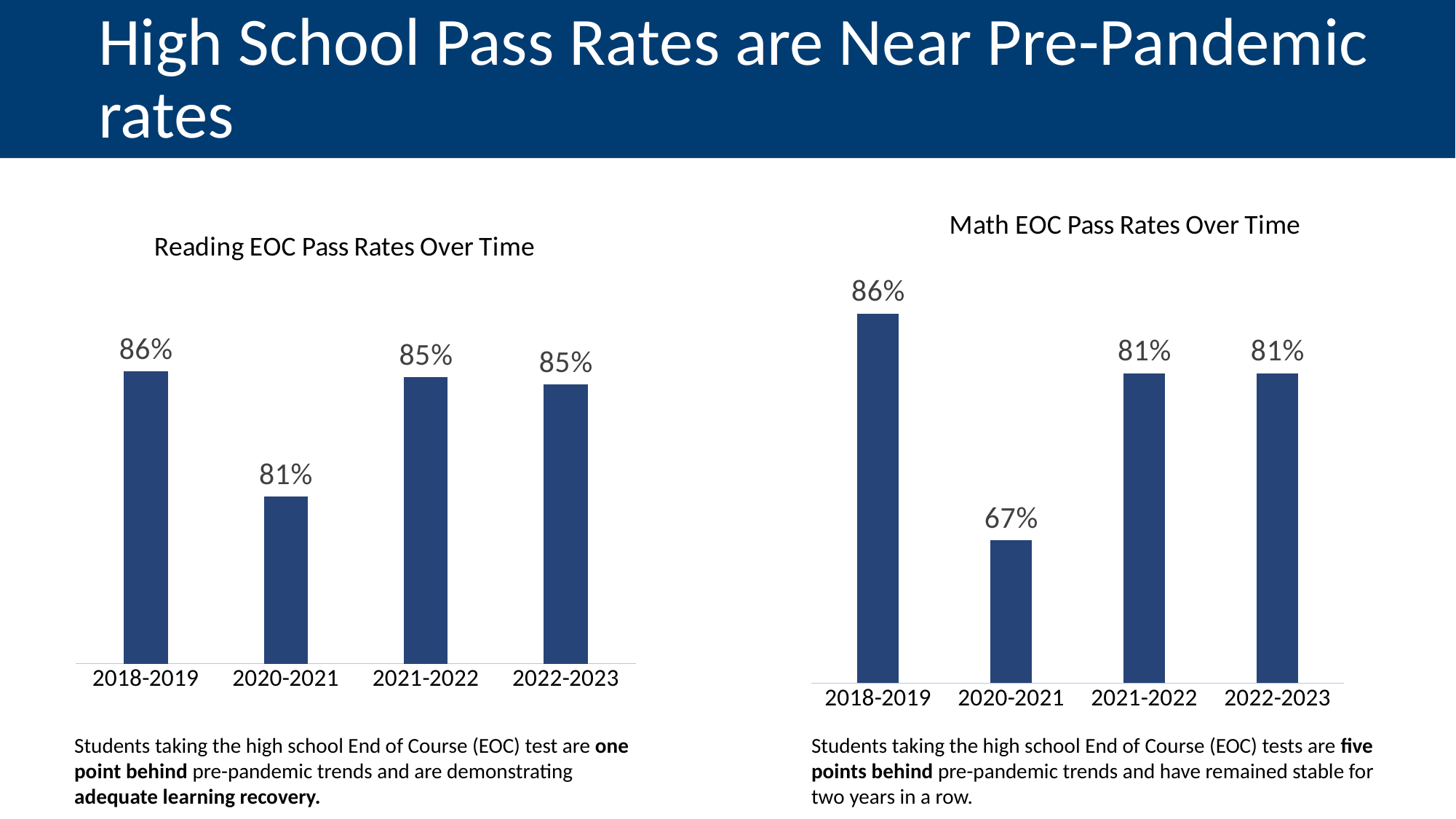
In the Reading EOC Pass Rates Over Time chart, what is the pass rate for 2022-2023? 85% In the Reading EOC Pass Rates Over Time chart, what is the pass rate for 2020-2021? 81% In the Math EOC Pass Rates Over Time chart, what is the pass rate for 2020-2021? 67% In the Math EOC Pass Rates Over Time chart, which school year has the highest pass rate? 2018-2019 In the Math EOC Pass Rates Over Time chart, did the pass rate rise or fall from 2020-2021 to 2021-2022? Rise How many school years are shown in the Math EOC Pass Rates Over Time chart? 4 In the Reading EOC Pass Rates Over Time chart, which school year has the lowest pass rate? 2020-2021 In the Reading EOC Pass Rates Over Time chart, what is the difference between the 2018-2019 and 2022-2023 pass rates? 1% Which is larger: the 2021-2022 pass rate in the Reading EOC chart or the 2021-2022 pass rate in the Math EOC chart? Reading EOC chart In the Math EOC Pass Rates Over Time chart, what is the pass rate for 2018-2019? 86% In the Math EOC Pass Rates Over Time chart, what is the difference between the 2018-2019 and 2020-2021 pass rates? 19% What type of chart is the Reading EOC Pass Rates Over Time chart? Bar chart